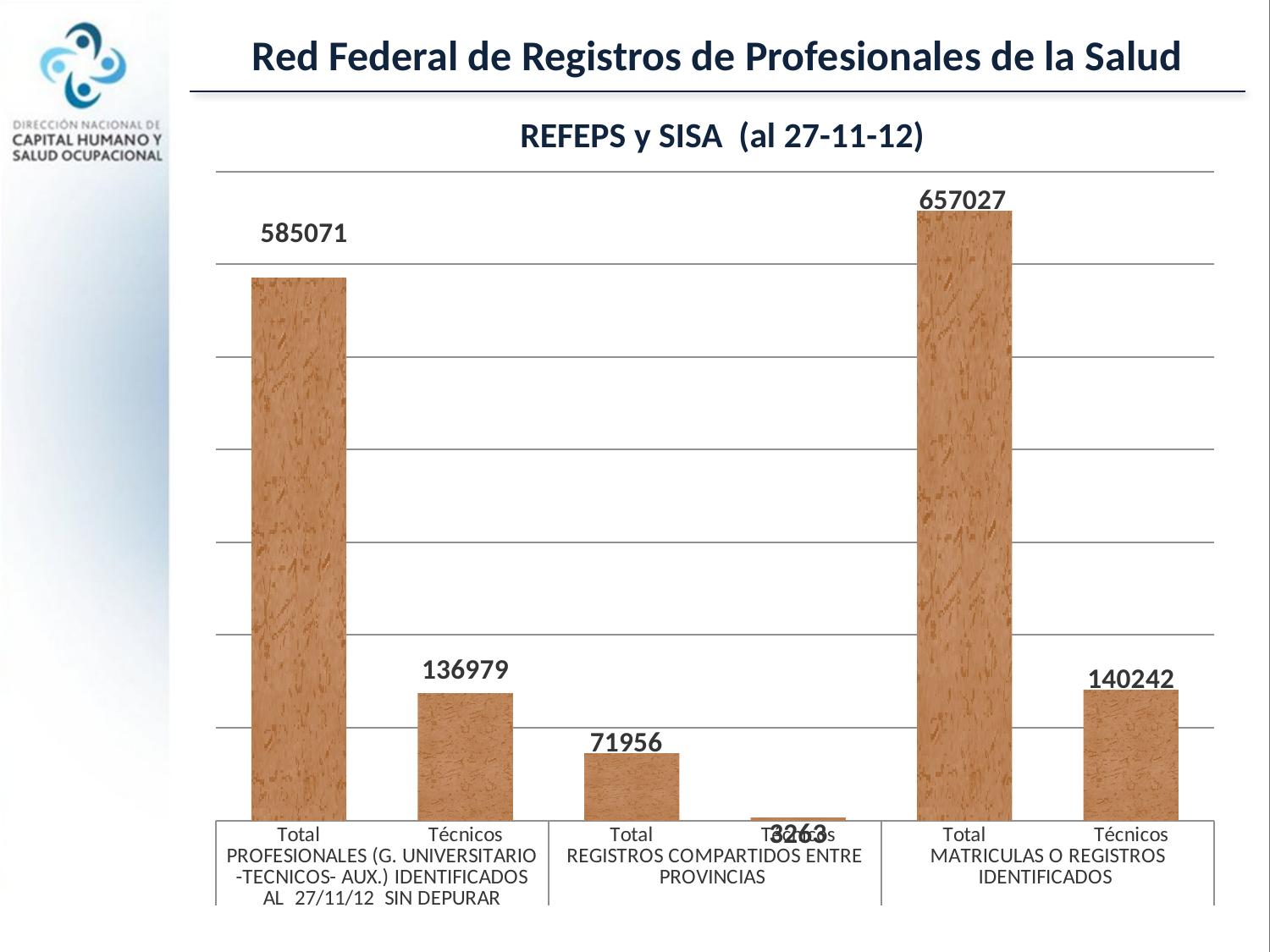
Which is larger: the Técnicos bar for MATRICULAS O REGISTROS IDENTIFICADOS or the Técnicos bar for PROFESIONALES IDENTIFICADOS AL 27/11/12 SIN DEPURAR? Técnicos, MATRICULAS O REGISTROS IDENTIFICADOS What is the value of the Total bar in the REGISTROS COMPARTIDOS ENTRE PROVINCIAS group? 71956 Which bar has the lowest value in the chart? Técnicos, REGISTROS COMPARTIDOS ENTRE PROVINCIAS What is the value of the Total bar in the MATRICULAS O REGISTROS IDENTIFICADOS group? 657027 What is the value of the Técnicos bar in the PROFESIONALES (G. UNIVERSITARIO -TECNICOS- AUX.) IDENTIFICADOS AL 27/11/12 SIN DEPURAR group? 136979 What is the difference between the Técnicos bar for MATRICULAS O REGISTROS IDENTIFICADOS and the Técnicos bar for PROFESIONALES IDENTIFICADOS AL 27/11/12 SIN DEPURAR? 3263 Which bar has the highest value in the chart? Total, MATRICULAS O REGISTROS IDENTIFICADOS What is the value of the Técnicos bar in the MATRICULAS O REGISTROS IDENTIFICADOS group? 140242 What is the value of the Total bar in the PROFESIONALES (G. UNIVERSITARIO -TECNICOS- AUX.) IDENTIFICADOS AL 27/11/12 SIN DEPURAR group? 585071 What is the difference between the Total bar for MATRICULAS O REGISTROS IDENTIFICADOS and the Total bar for PROFESIONALES IDENTIFICADOS AL 27/11/12 SIN DEPURAR? 71956 What type of chart is shown on the slide? Bar chart How many bars are plotted in the chart? 6